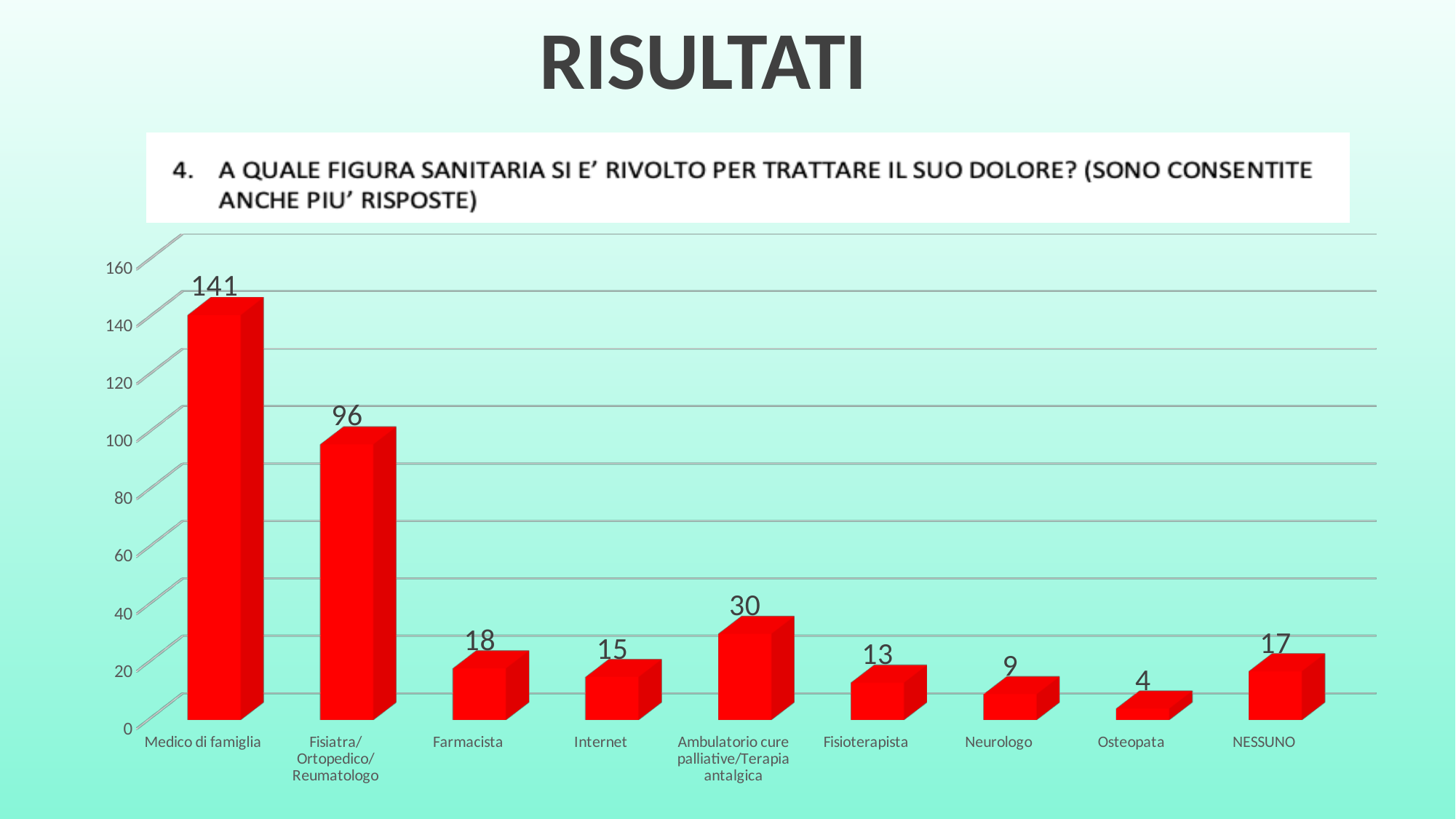
How many categories are shown on the x axis? 9 Which is larger, the value for Farmacista or the value for Internet? Farmacista What is the value for Ambulatorio cure palliative/Terapia antalgica? 30 What is the difference between the values for Medico di famiglia and Fisiatra/Ortopedico/Reumatologo? 45 What colour are the bars in the chart? red Which category has the highest value? Medico di famiglia What is the value for Medico di famiglia? 141 What kind of chart is shown on the slide? bar chart Which category has the lowest value? Osteopata What is the value for NESSUNO? 17 Is the value for Fisiatra/Ortopedico/Reumatologo greater or less than 100? less What is the value for Fisiatra/Ortopedico/Reumatologo? 96